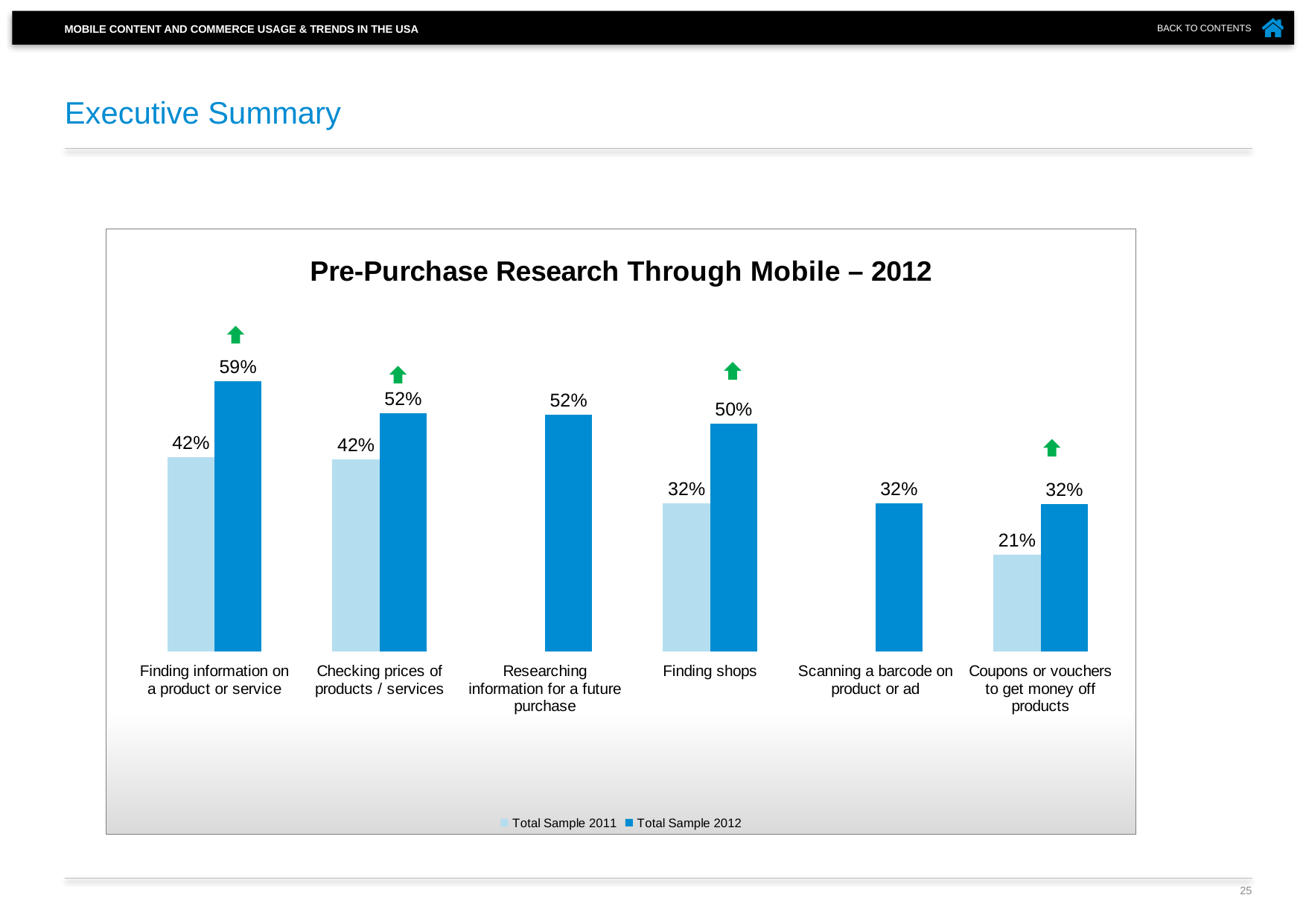
What is the Total Sample 2011 value for Coupons or vouchers to get money off products? 21% How many series does the legend list? 2 Which category has the lowest Total Sample 2011 value? Coupons or vouchers to get money off products Which category has the highest Total Sample 2012 value? Finding information on a product or service What is the difference between the Total Sample 2012 values for Finding information on a product or service and Checking prices of products / services? 7% How many categories are shown on the x axis? 6 What is the difference between the Total Sample 2012 and Total Sample 2011 values for Finding shops? 18% What kind of chart is shown? Bar chart What is the Total Sample 2012 value for Finding shops? 50% What is the Total Sample 2012 value for Finding information on a product or service? 59% What is the title of the chart? Pre-Purchase Research Through Mobile – 2012 Which is larger: the Total Sample 2012 value for Checking prices of products / services or for Scanning a barcode on product or ad? Checking prices of products / services